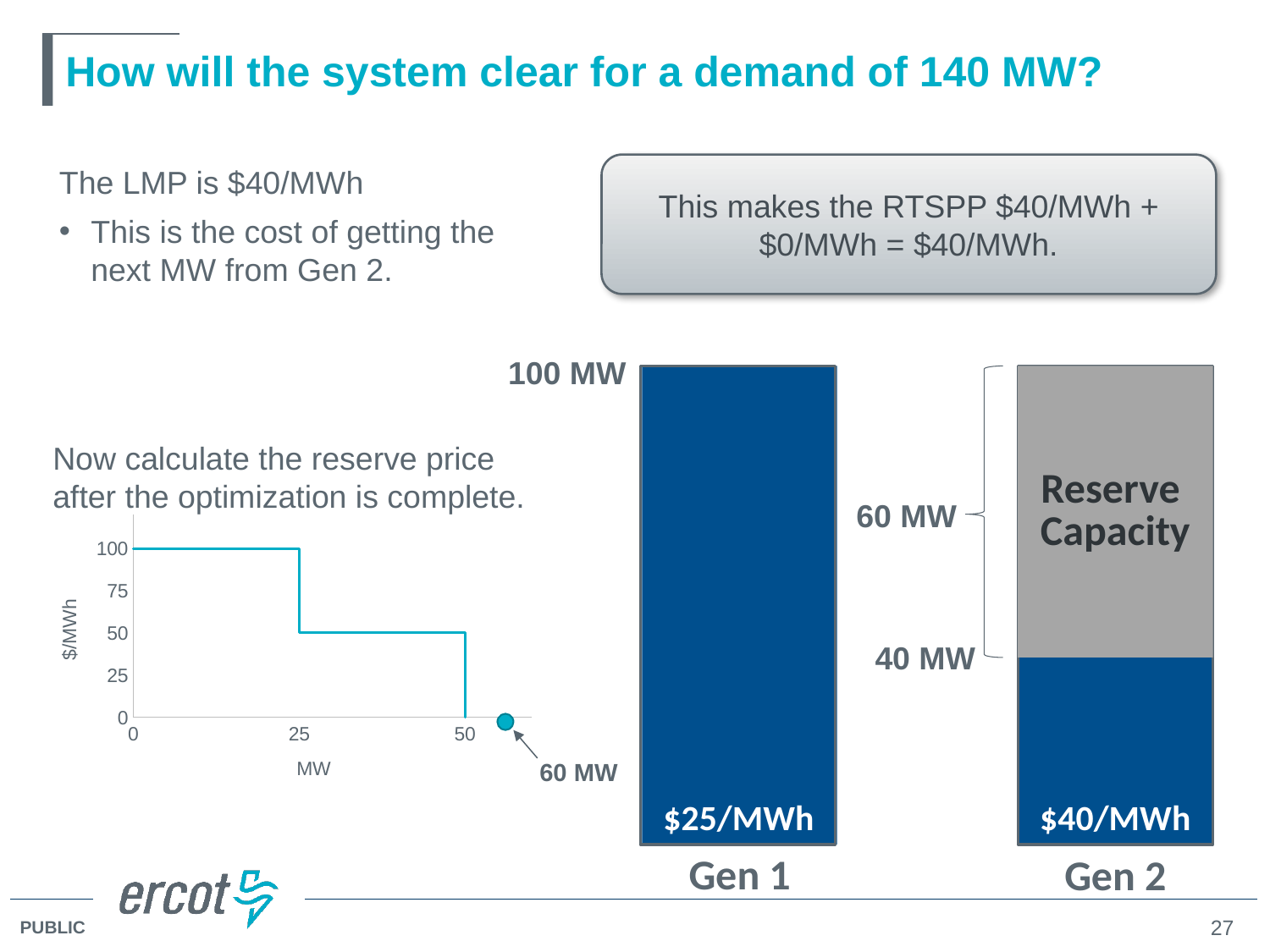
In the step chart on the left, what is the label on the y axis? $/MWh In the bar chart on the right, what is the price label shown for Gen 2? $40/MWh In the step chart on the left, does the $/MWh value rise or fall as MW increases? fall In the bar chart on the right, what is the difference between the Gen 2 price and the Gen 1 price? $15/MWh In the bar chart on the right, how much of Gen 2 is labelled as Reserve Capacity? 60 MW How many generators are shown in the bar chart on the right? 2 In the bar chart on the right, what capacity is labelled for the Gen 1 bar? 100 MW In the step chart on the left, what is the $/MWh value for quantities between 25 and 50 MW? 50 In the bar chart on the right, what is the price label shown for Gen 1? $25/MWh In the bar chart on the right, what is the total height of the Gen 2 bar (dispatched plus reserve capacity)? 100 MW In the step chart on the left, what is the $/MWh value for quantities between 0 and 25 MW? 100 In the bar chart on the right, which generator has the higher price per MWh, Gen 1 or Gen 2? Gen 2